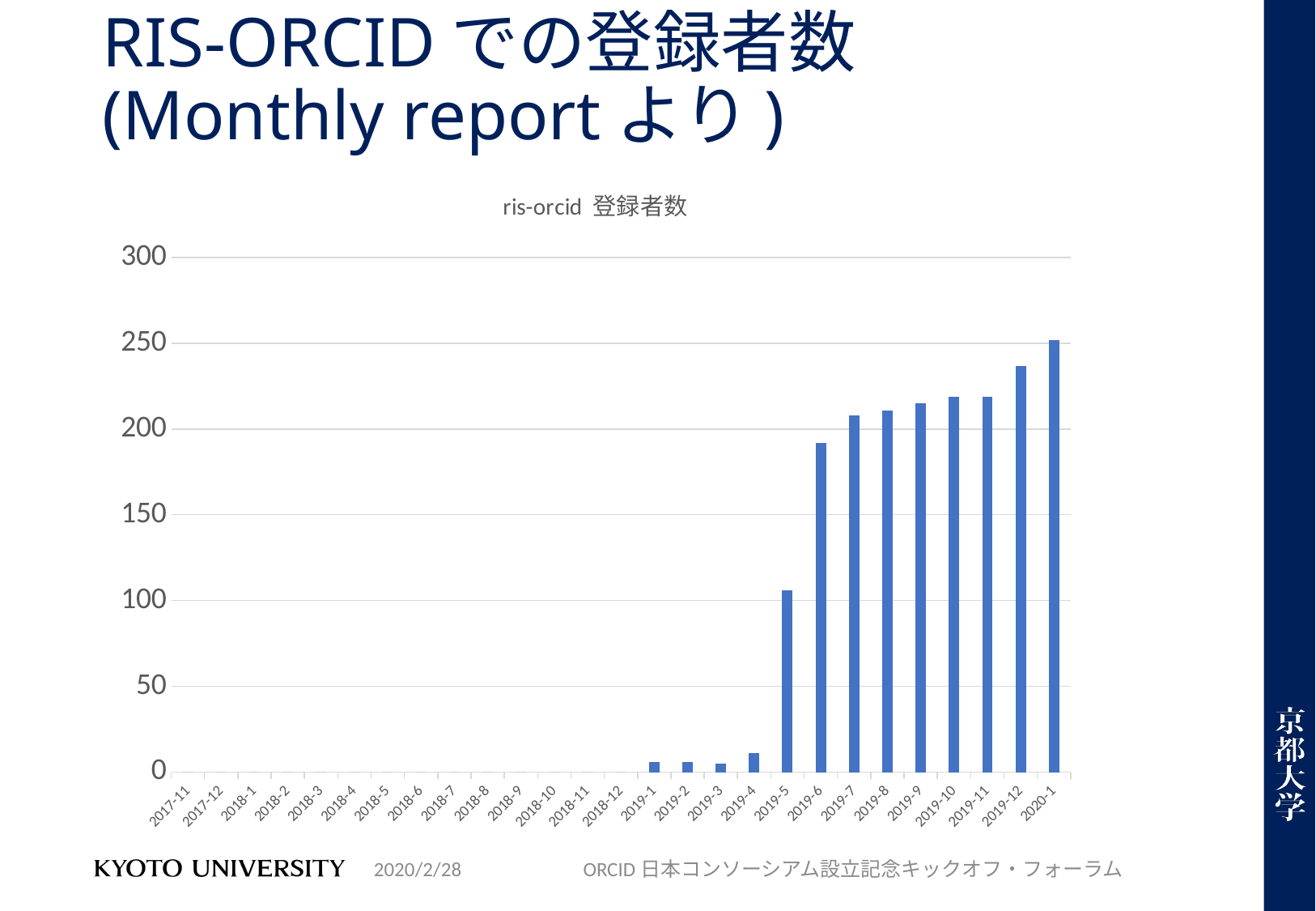
Do the values generally rise or fall from 2019-5 to 2020-1? rise Is the value for 2019-4 greater or less than 50? less Is the value for 2019-5 greater or less than 150? less Which is larger, the value for 2019-12 or the value for 2020-1? 2020-1 How many months are shown on the x axis of the chart? 27 Is the value for 2019-6 greater or less than 150? greater Which month has the highest value in the chart? 2020-1 Which is larger, the value for 2019-5 or the value for 2019-6? 2019-6 What kind of chart is shown on the slide? bar chart What is the title of the chart? ris-orcid 登録者数